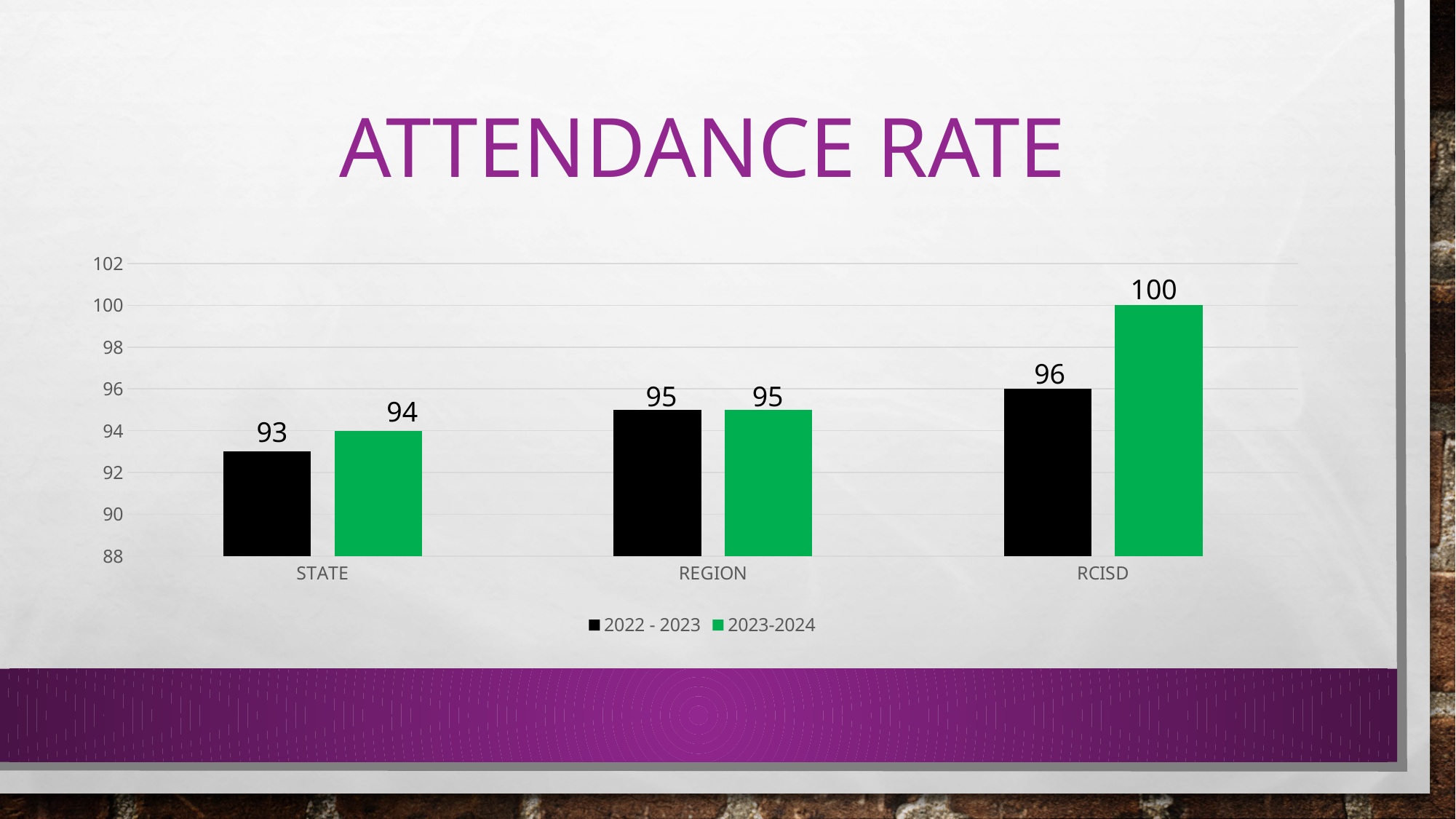
What kind of chart is shown on the slide? Bar chart Which category has the lowest attendance rate in 2022 - 2023? STATE What is the attendance rate for REGION in 2023-2024? 95 How many categories are shown on the x axis? 3 Which is larger, the STATE attendance rate in 2023-2024 or the REGION attendance rate in 2023-2024? REGION Which category has the highest attendance rate in 2023-2024? RCISD What is the attendance rate for RCISD in 2023-2024? 100 What is the difference between the RCISD attendance rate in 2023-2024 and in 2022 - 2023? 4 What is the difference between the RCISD and STATE attendance rates in 2022 - 2023? 3 What is the attendance rate for STATE in 2022 - 2023? 93 What colour are the bars for the 2023-2024 series? Green How many series does the legend list? 2